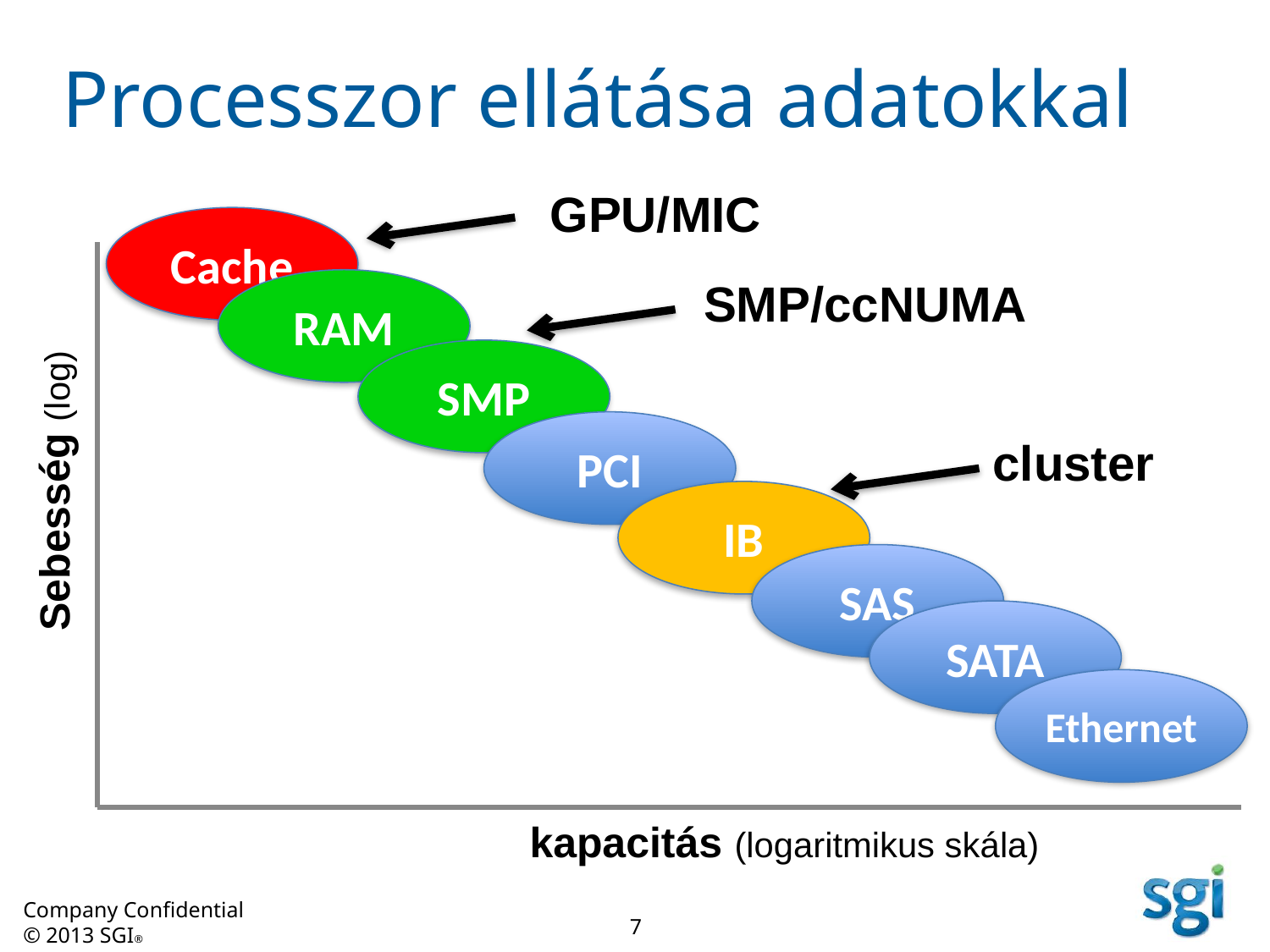
What colour is the IB ellipse? Orange Which is placed higher on the speed axis, RAM or SATA? RAM What is the label of the vertical axis? Sebesség (log) Which item is positioned highest on the Sebesség (speed) axis? Cache Which item is positioned lowest on the Sebesség (speed) axis? Ethernet Which is placed higher on the speed axis, PCI or IB? PCI Which item is positioned furthest left on the kapacitás (capacity) axis? Cache Does speed rise or fall as capacity increases along the x axis? fall How many labelled ellipses are plotted on the chart? 8 Which item lies between PCI and SAS on the chart? IB Which item is positioned furthest right on the kapacitás (capacity) axis? Ethernet